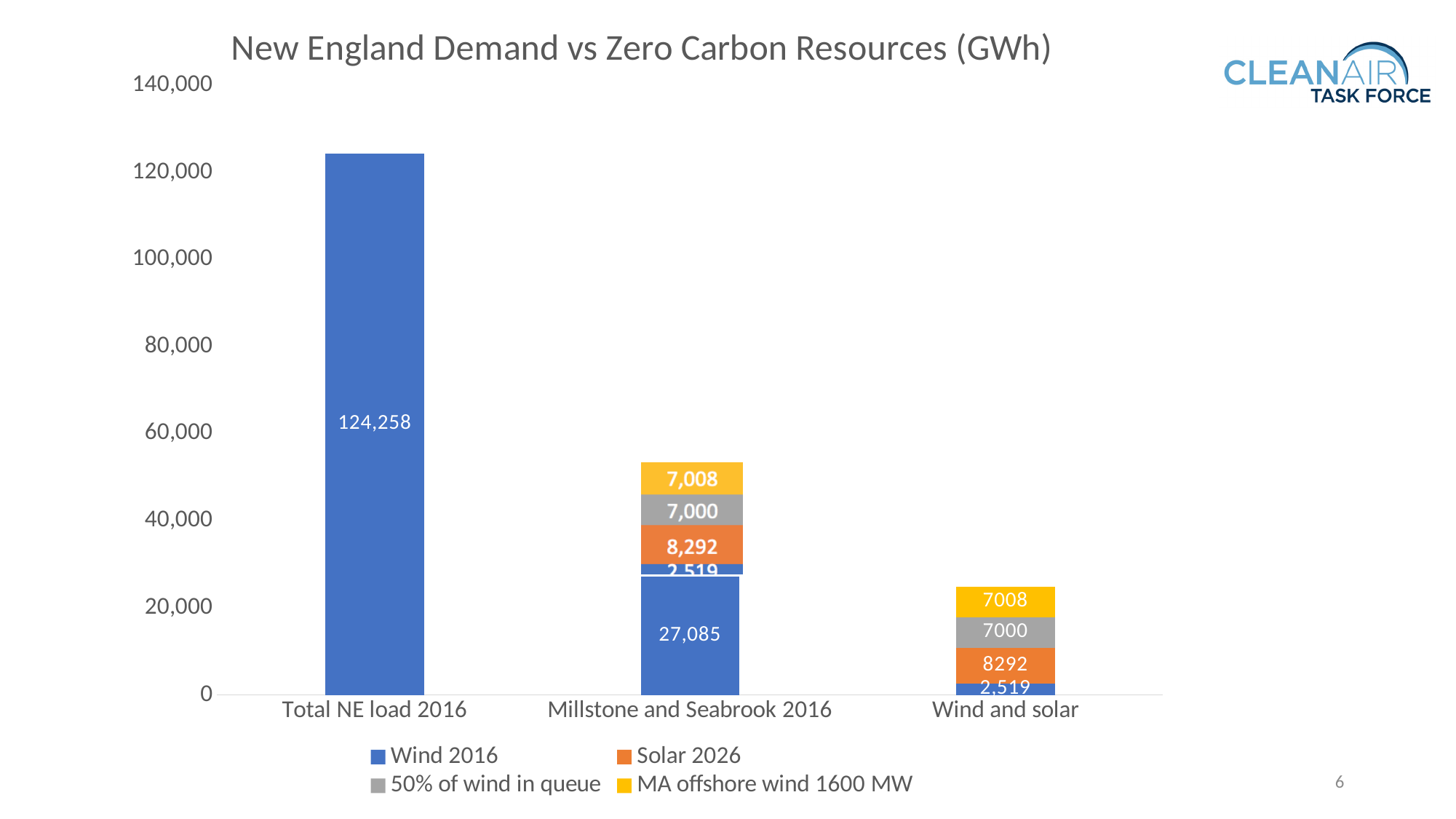
What type of chart is shown on the slide? stacked bar chart What is the MA offshore wind 1600 MW value in the Wind and solar bar? 7008 Is the total height of the Millstone and Seabrook 2016 bar greater or less than 40,000? greater How many categories are shown on the x axis? 3 Which category has the shortest bar? Wind and solar Which category has the tallest bar? Total NE load 2016 What is the Solar 2026 value in the Wind and solar bar? 8292 What is the value of the Total NE load 2016 bar? 124,258 How many series does the legend list? 4 What is the difference between the Total NE load 2016 value (124,258) and the 27,085 segment of the Millstone and Seabrook 2016 bar? 97,173 What is the Wind 2016 value in the Wind and solar bar? 2,519 Is the Total NE load 2016 bar larger or smaller than the Millstone and Seabrook 2016 bar? larger